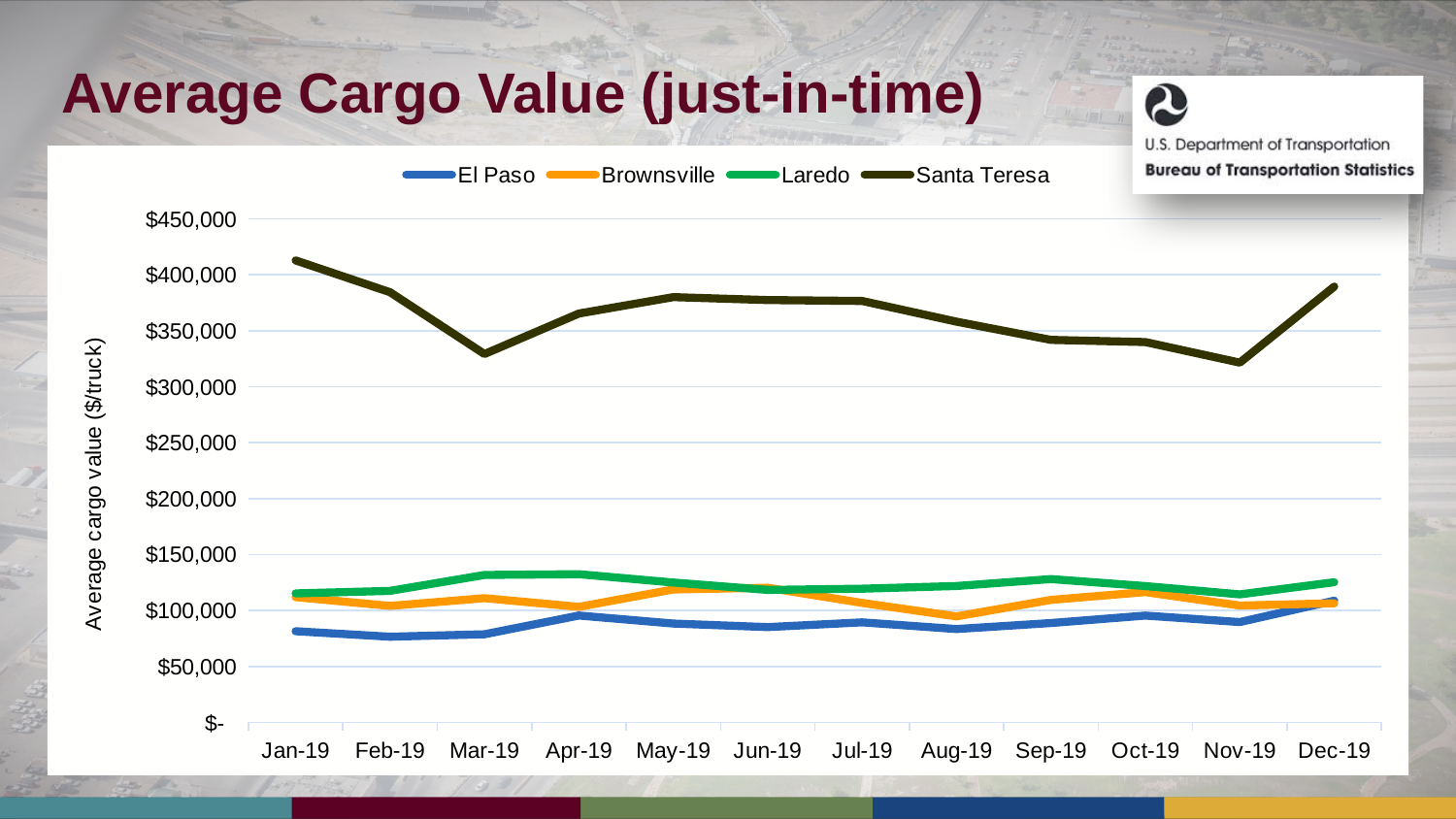
Does the Santa Teresa line rise or fall from Jan-19 to Mar-19? Falls How many series does the legend list? 4 What is the label on the y axis? Average cargo value ($/truck) How many months are plotted along the x axis? 12 Is the value for Santa Teresa in Mar-19 greater or less than $350,000? less In which month does Santa Teresa reach its highest value? Jan-19 Which series has the lowest average cargo value in Jan-19? El Paso Is the value for Santa Teresa in Jan-19 greater or less than $400,000? greater Which series has the highest average cargo value throughout 2019? Santa Teresa Is the value for Laredo in Apr-19 greater or less than $100,000? greater What kind of chart is shown on the slide? Line chart